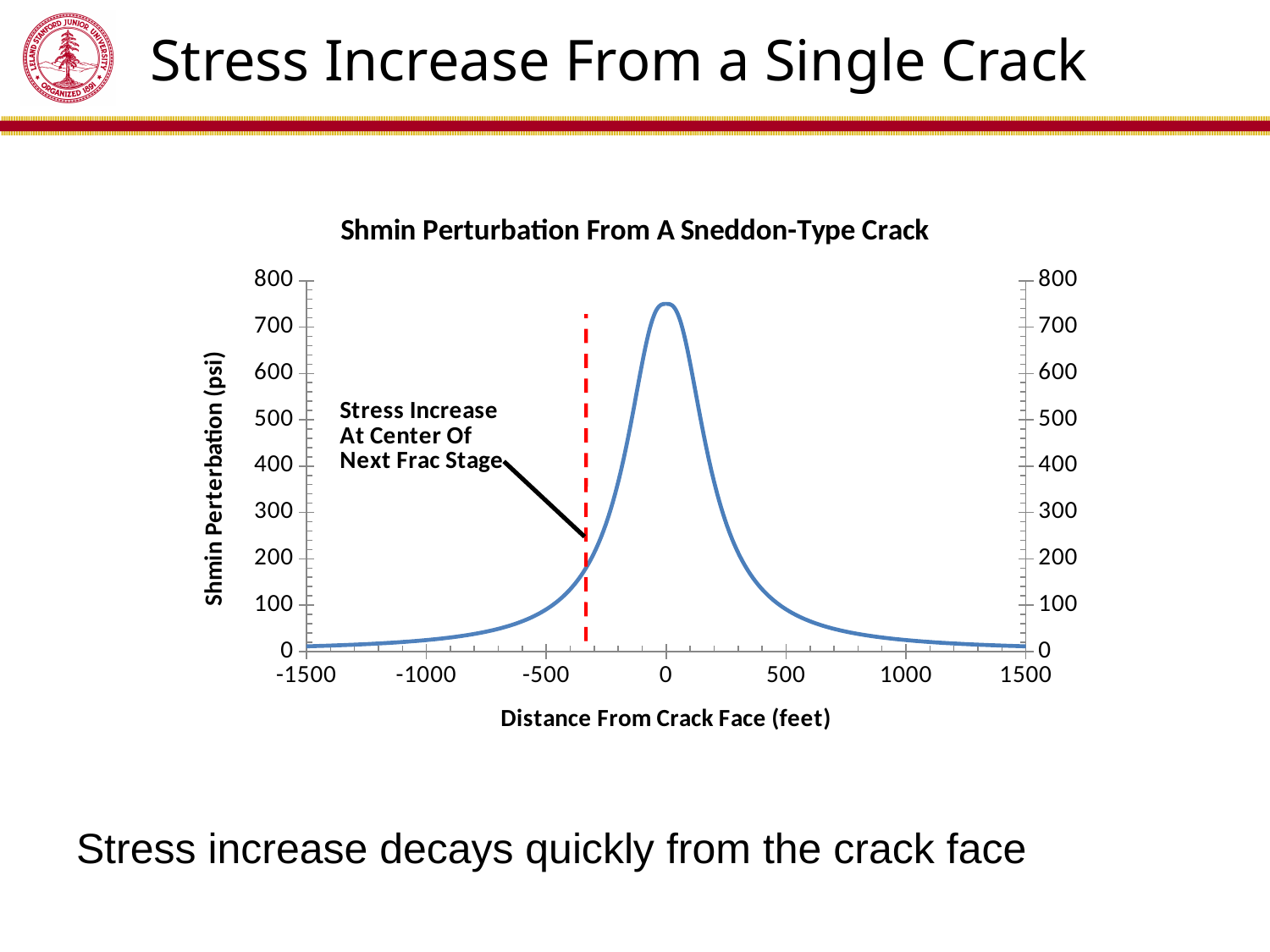
What is the title of the chart? Shmin Perturbation From A Sneddon-Type Crack What kind of chart is shown on the slide? Line chart Do the values rise or fall as the distance increases from 0 to 1500 feet? fall Is the Shmin perturbation at a distance of 0 feet greater or less than 700 psi? greater At which distance from the crack face does the Shmin perturbation reach its highest value? 0 Do the values rise or fall as the distance increases from -1500 to 0 feet? rise Which has the larger Shmin perturbation: a distance of 0 feet or a distance of 500 feet? 0 feet Is the Shmin perturbation at a distance of 1000 feet greater or less than 100 psi? less Is the Shmin perturbation at a distance of 1500 feet greater or less than 100 psi? less What is the label of the x axis? Distance From Crack Face (feet)